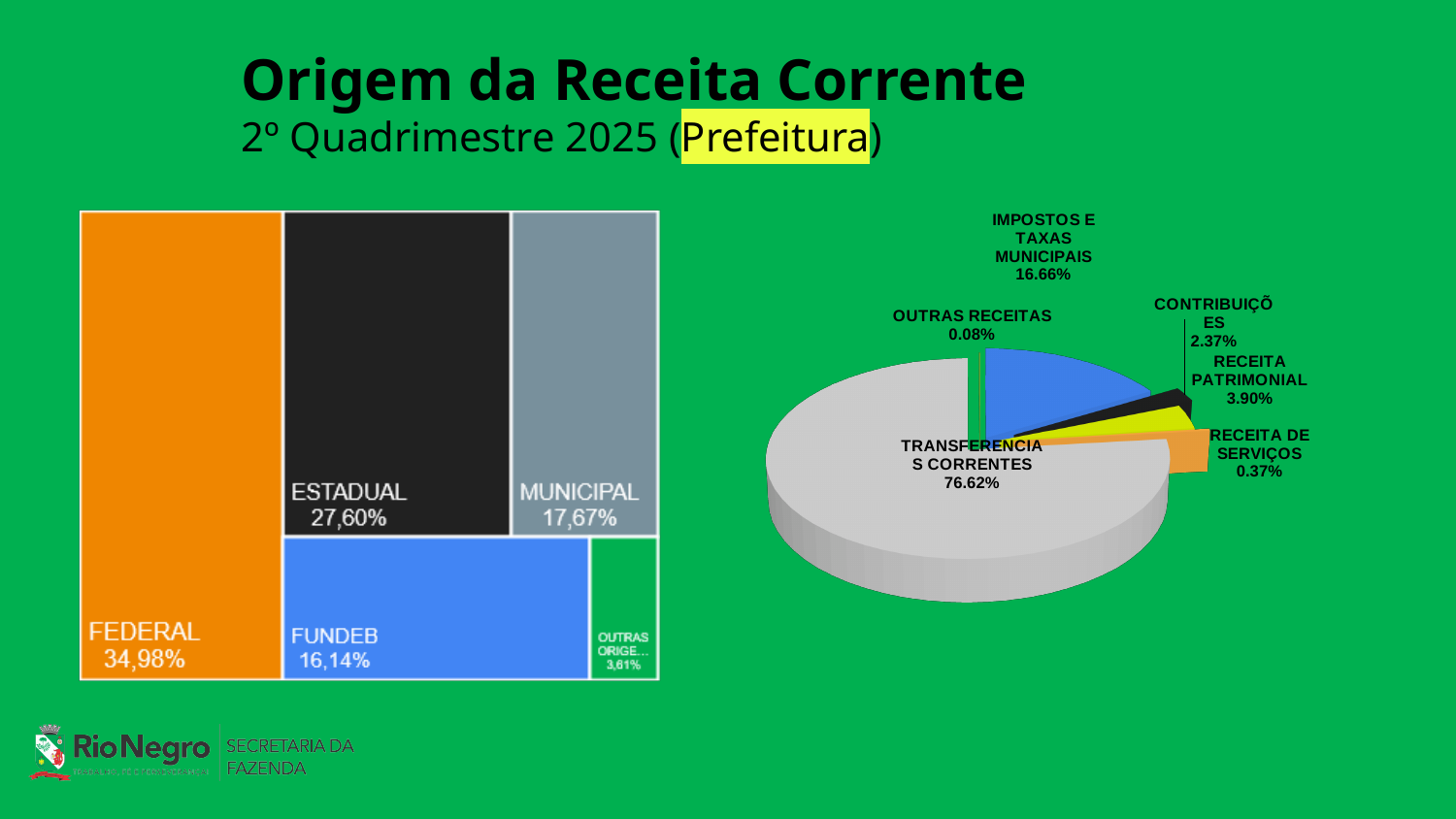
In the treemap chart on the left, which category has the highest value? FEDERAL In the pie chart on the right, what is the share for IMPOSTOS E TAXAS MUNICIPAIS? 16.66% In the treemap chart on the left, what is the difference between the values for ESTADUAL and MUNICIPAL? 9,93% In the pie chart on the right, what is the share for RECEITA PATRIMONIAL? 3.90% In the pie chart on the right, what is the difference between the shares of CONTRIBUIÇÕES and RECEITA DE SERVIÇOS? 2.00% In the treemap chart on the left, which is larger, ESTADUAL or MUNICIPAL? ESTADUAL In the pie chart on the right, what is the share for TRANSFERÊNCIAS CORRENTES? 76.62% In the pie chart on the right, which category has the largest share? TRANSFERÊNCIAS CORRENTES In the treemap chart on the left, what is the value for FUNDEB? 16,14% In the treemap chart on the left, what is the value for FEDERAL? 34,98% In the pie chart on the right, how many slices are labelled? 6 In the pie chart on the right, which category has the smallest share? OUTRAS RECEITAS